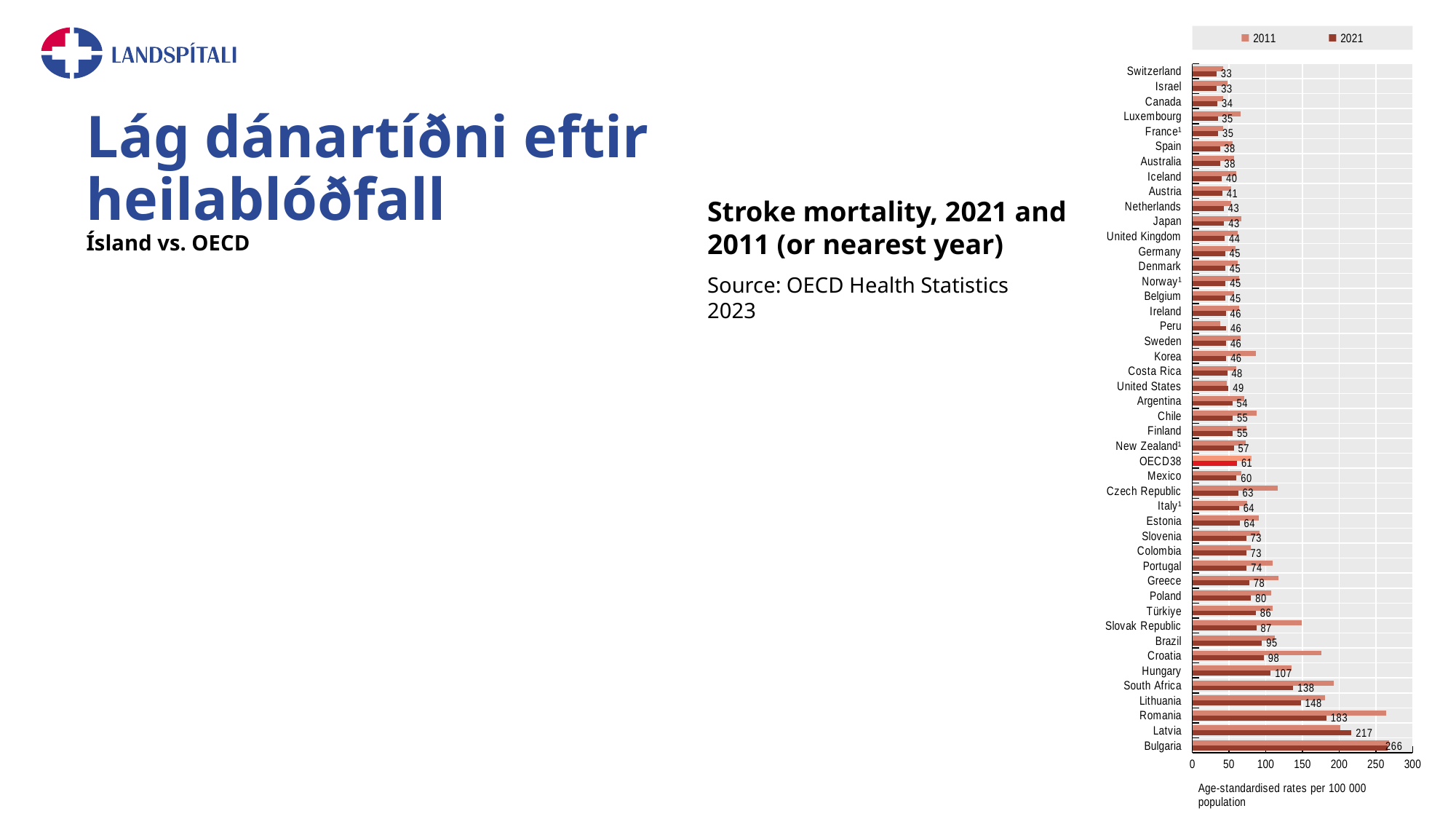
What is the 2021 stroke mortality rate for Iceland? 40 What is the difference between the 2021 values for OECD38 and Iceland? 21 What is the 2021 value shown for Latvia? 217 Which country has the highest 2021 stroke mortality rate? Bulgaria Which has a higher 2021 value, Iceland or OECD38? OECD38 What is the title of the chart? Stroke mortality, 2021 and 2011 (or nearest year) Is the 2011 value for Romania greater or less than 250? greater Is the 2011 value for Croatia greater or less than 150? greater What kind of chart is shown on the slide? Bar chart What is the 2021 value shown for OECD38? 61 What is the difference between the 2021 values for Bulgaria and Latvia? 49 How many series does the legend list? 2